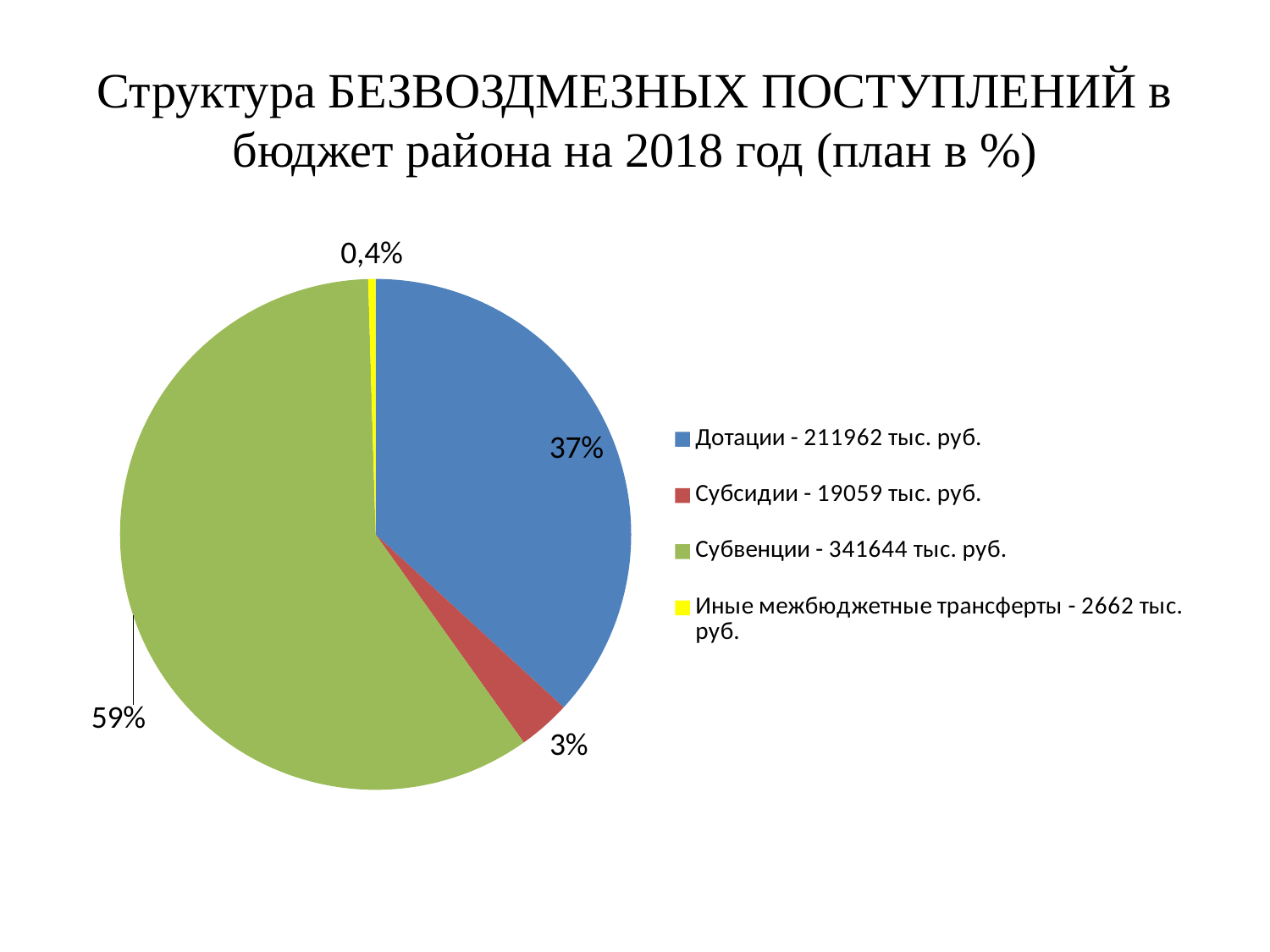
What share of the pie does Субвенции account for? 59% What percentage is shown for Субсидии? 3% What percentage is shown for Иные межбюджетные трансферты? 0,4% What share of the pie does Дотации account for? 37% What kind of chart is shown on the slide? Pie chart Which is larger, the share for Дотации or the share for Субсидии? Дотации By how many percentage points does the share of Субвенции exceed the share of Дотации? 22 Which category has the largest slice of the pie? Субвенции How many slices does the pie chart have? 4 According to the legend, what amount in тыс. руб. is given for Субсидии? 19059 тыс. руб. What colour is the Субвенции slice in the pie chart? Green Which category has the smallest slice of the pie? Иные межбюджетные трансферты